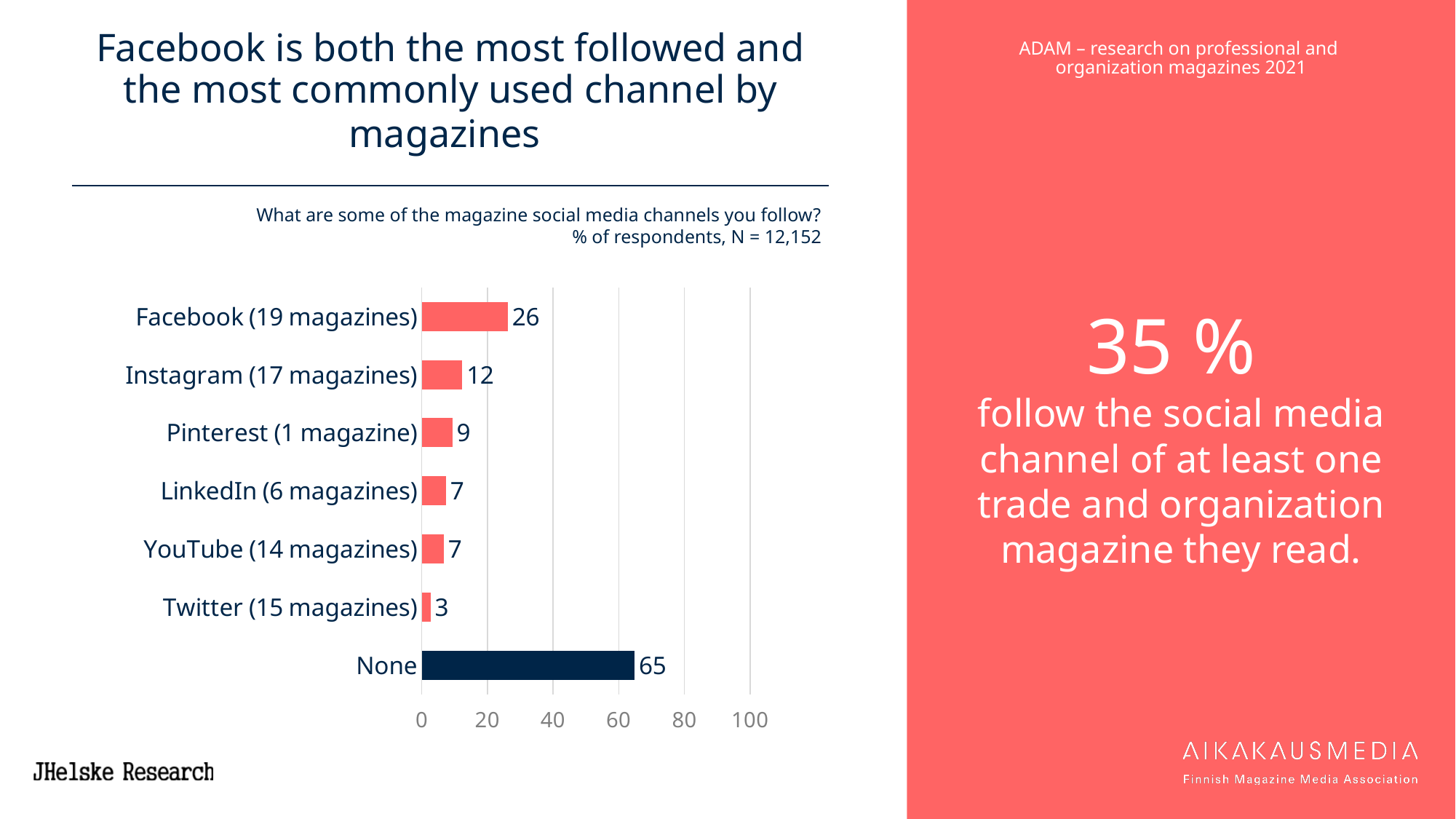
What is the difference between the values for Facebook (19 magazines) and Instagram (17 magazines)? 14 What is the value for Facebook (19 magazines)? 26 Which is larger, the value for Pinterest (1 magazine) or the value for LinkedIn (6 magazines)? Pinterest (1 magazine) What is the value for Twitter (15 magazines)? 3 Which category has the highest value? None How many categories are shown in the chart? 7 Is the value for None greater or less than 60? greater What is the value for None? 65 What is the value for Instagram (17 magazines)? 12 Which category has the lowest value? Twitter (15 magazines) What kind of chart is shown on the slide? bar chart What colour is the bar for None? dark navy blue